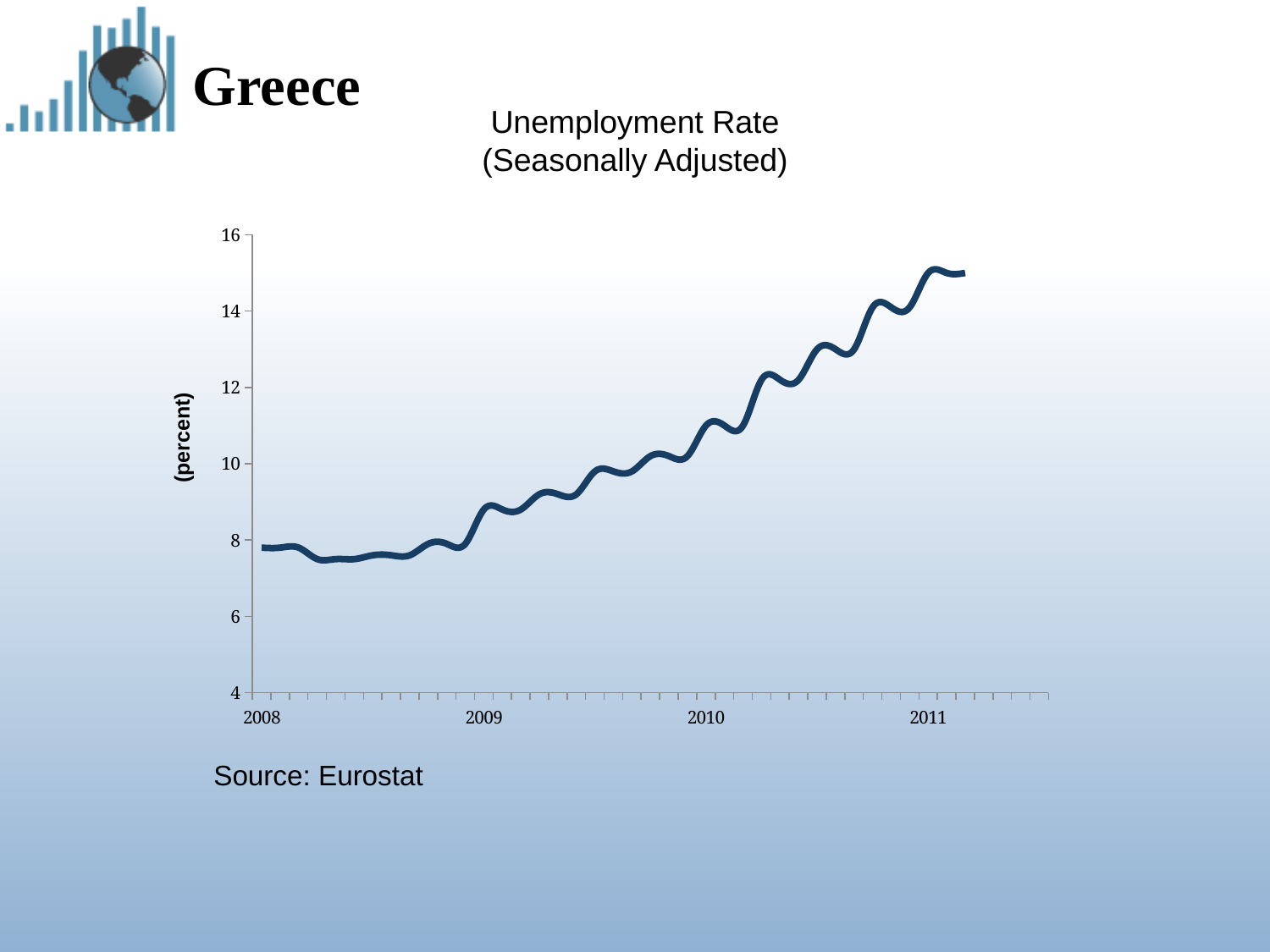
Is the unemployment rate higher at the start of 2009 or at the start of 2011? 2011 Is the unemployment rate at the start of 2008 greater or less than 10? less What is the label on the vertical axis? (percent) What kind of chart is shown on the slide? line chart Is the unemployment rate at the start of 2009 greater or less than 12? less Is the unemployment rate at the start of 2010 greater or less than 8? greater How many year labels are shown on the x axis? 4 Which labelled year on the x axis has the highest unemployment rate? 2011 Does the unemployment rate generally rise or fall from 2008 to 2011? rise Which labelled year on the x axis has the lowest unemployment rate? 2008 What is the title of the chart? Unemployment Rate (Seasonally Adjusted)